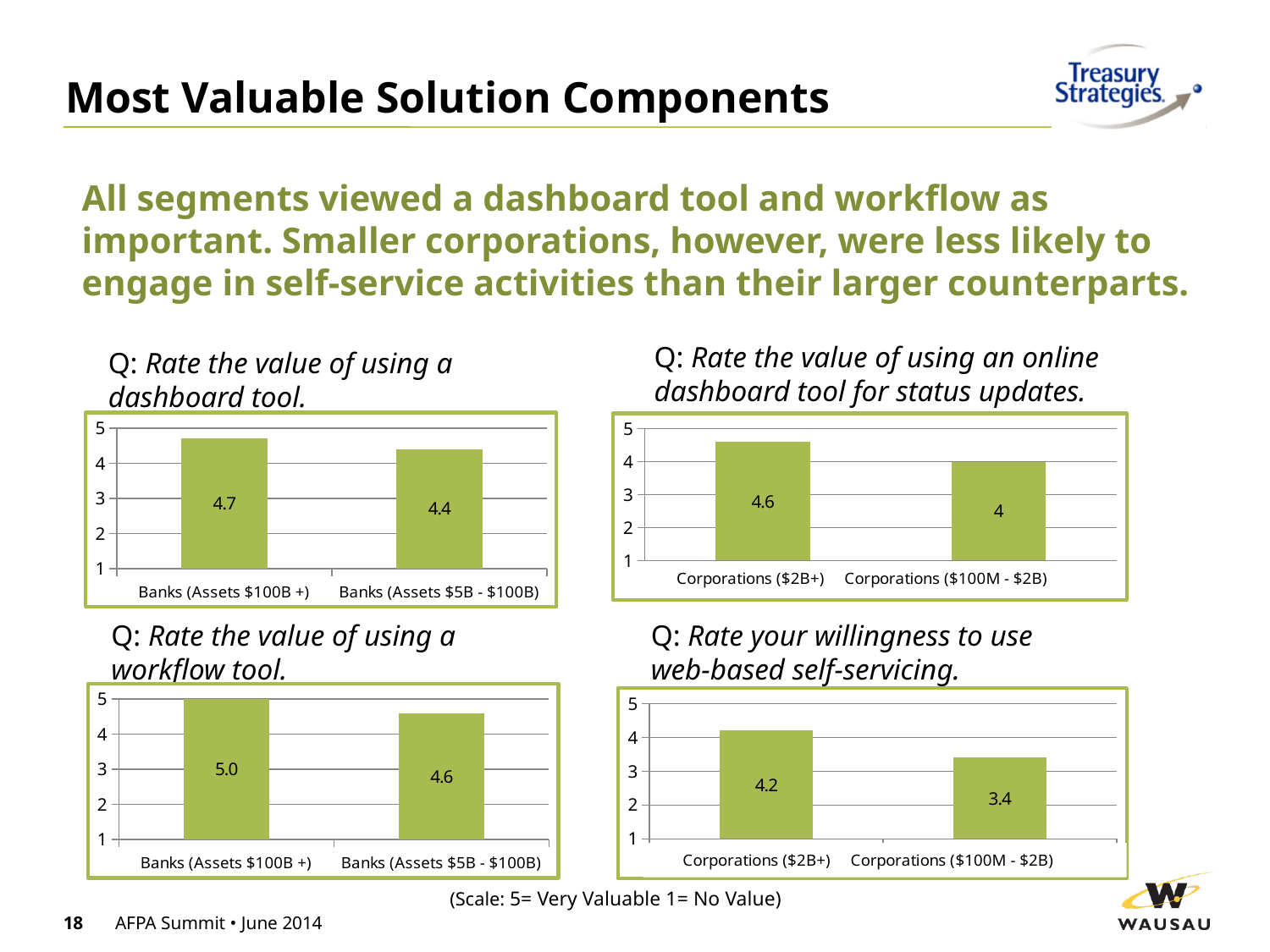
In the bottom-left chart (Rate the value of using a workflow tool), which category has the lowest value? Banks (Assets $5B - $100B) What kind of chart is the top-right chart (Rate the value of using an online dashboard tool for status updates)? Bar chart In the top-left chart (Rate the value of using a dashboard tool), what is the value for Banks (Assets $100B +)? 4.7 In the bottom-right chart (Rate your willingness to use web-based self-servicing), what is the difference between the values for Corporations ($2B+) and Corporations ($100M - $2B)? 0.8 In the top-left chart (Rate the value of using a dashboard tool), what is the value for Banks (Assets $5B - $100B)? 4.4 In the bottom-right chart (Rate your willingness to use web-based self-servicing), which category has the highest value? Corporations ($2B+) In the top-right chart (Rate the value of using an online dashboard tool for status updates), what is the value for Corporations ($100M - $2B)? 4 How many categories are shown in the bottom-left chart (Rate the value of using a workflow tool)? 2 In the top-left chart (Rate the value of using a dashboard tool), which is larger: the value for Banks (Assets $100B +) or Banks (Assets $5B - $100B)? Banks (Assets $100B +) In the top-right chart (Rate the value of using an online dashboard tool for status updates), what is the difference between the values for Corporations ($2B+) and Corporations ($100M - $2B)? 0.6 In the bottom-right chart (Rate your willingness to use web-based self-servicing), what is the value for Corporations ($100M - $2B)? 3.4 In the bottom-left chart (Rate the value of using a workflow tool), what is the value for Banks (Assets $100B +)? 5.0